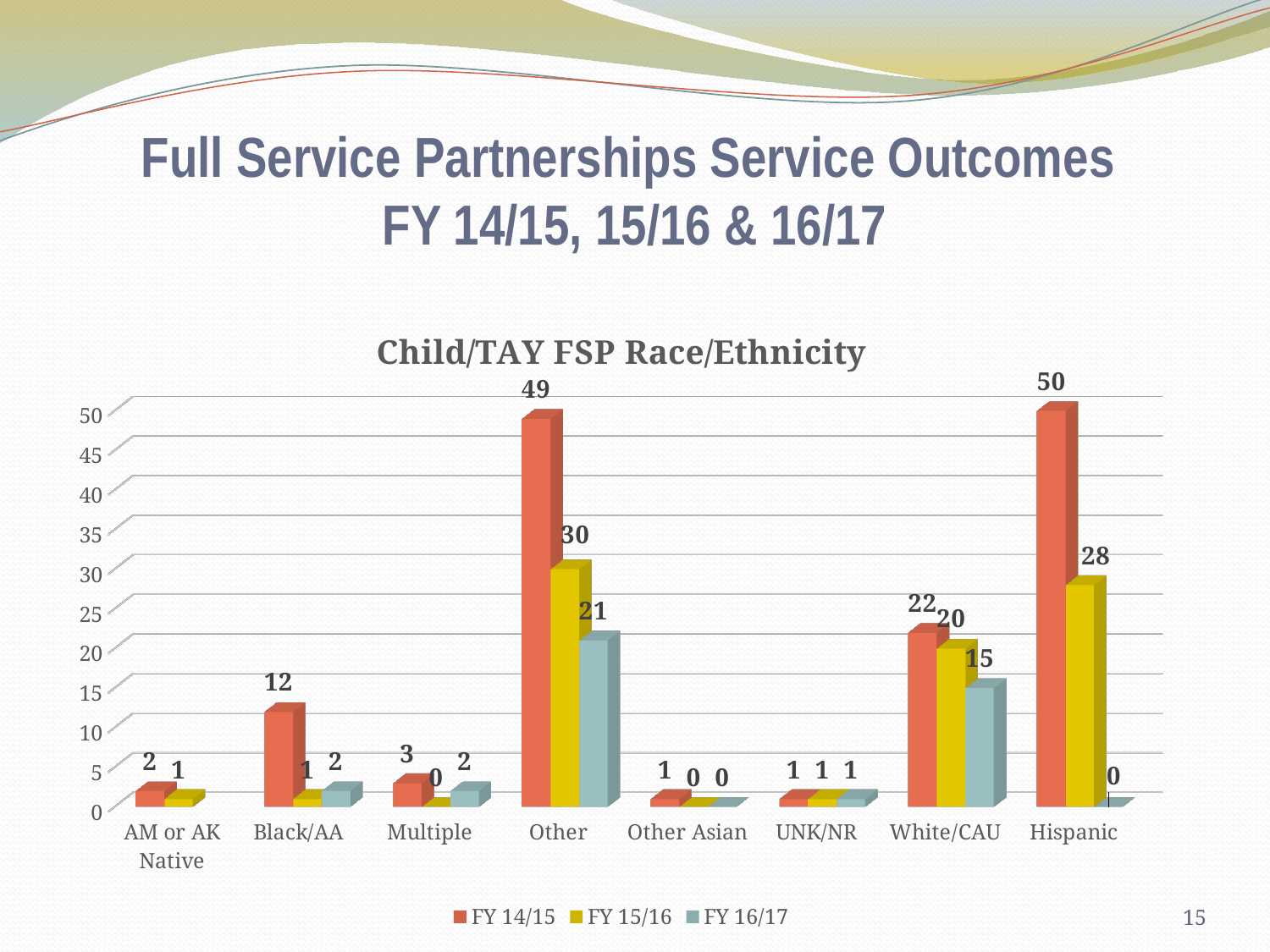
What is the FY 14/15 value for Black/AA? 12 What is the difference between the FY 14/15 values for Hispanic and White/CAU? 28 What is the FY 15/16 value for Hispanic? 28 How many race/ethnicity categories are shown on the x axis? 8 Which category has the highest FY 14/15 value? Hispanic How many series does the legend list? 3 What is the FY 16/17 value for White/CAU? 15 What is the FY 14/15 value for Other? 49 What is the difference between the FY 14/15 and FY 15/16 values for Other? 19 Which is larger for White/CAU: the FY 14/15 value or the FY 16/17 value? FY 14/15 Which category has the highest FY 16/17 value? Other What type of chart is shown on the slide? Bar chart